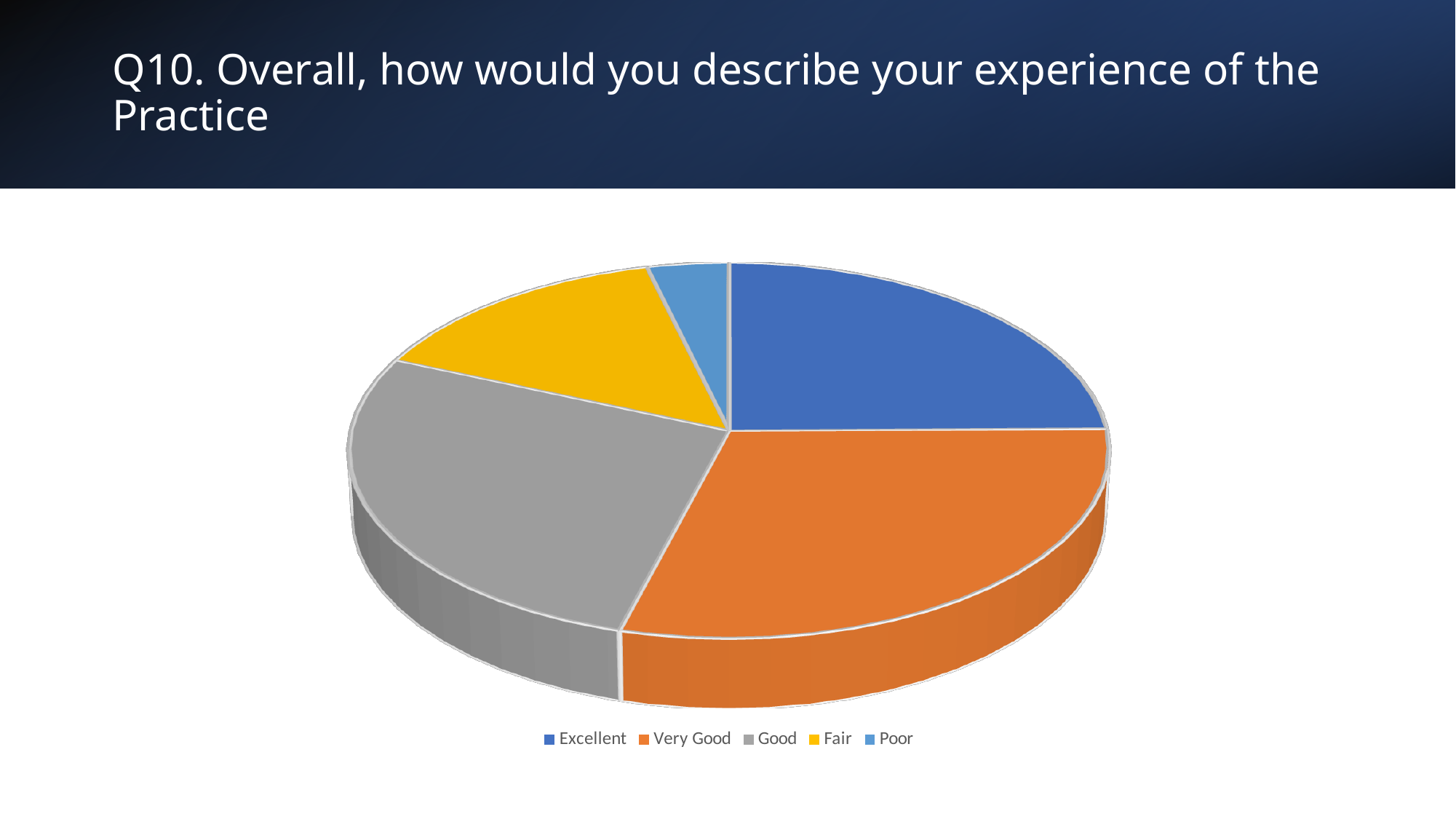
Which category has the smallest slice of the pie? Poor How many entries does the legend list? 5 Which slice is larger, Excellent or Poor? Excellent Which slice is larger, Fair or Poor? Fair How many categories does the pie chart show? 5 Which slice is larger, Excellent or Fair? Excellent Which category is shown in orange in the pie chart? Very Good What kind of chart is shown on the slide? pie chart What is the title of the slide containing the pie chart? Q10. Overall, how would you describe your experience of the Practice